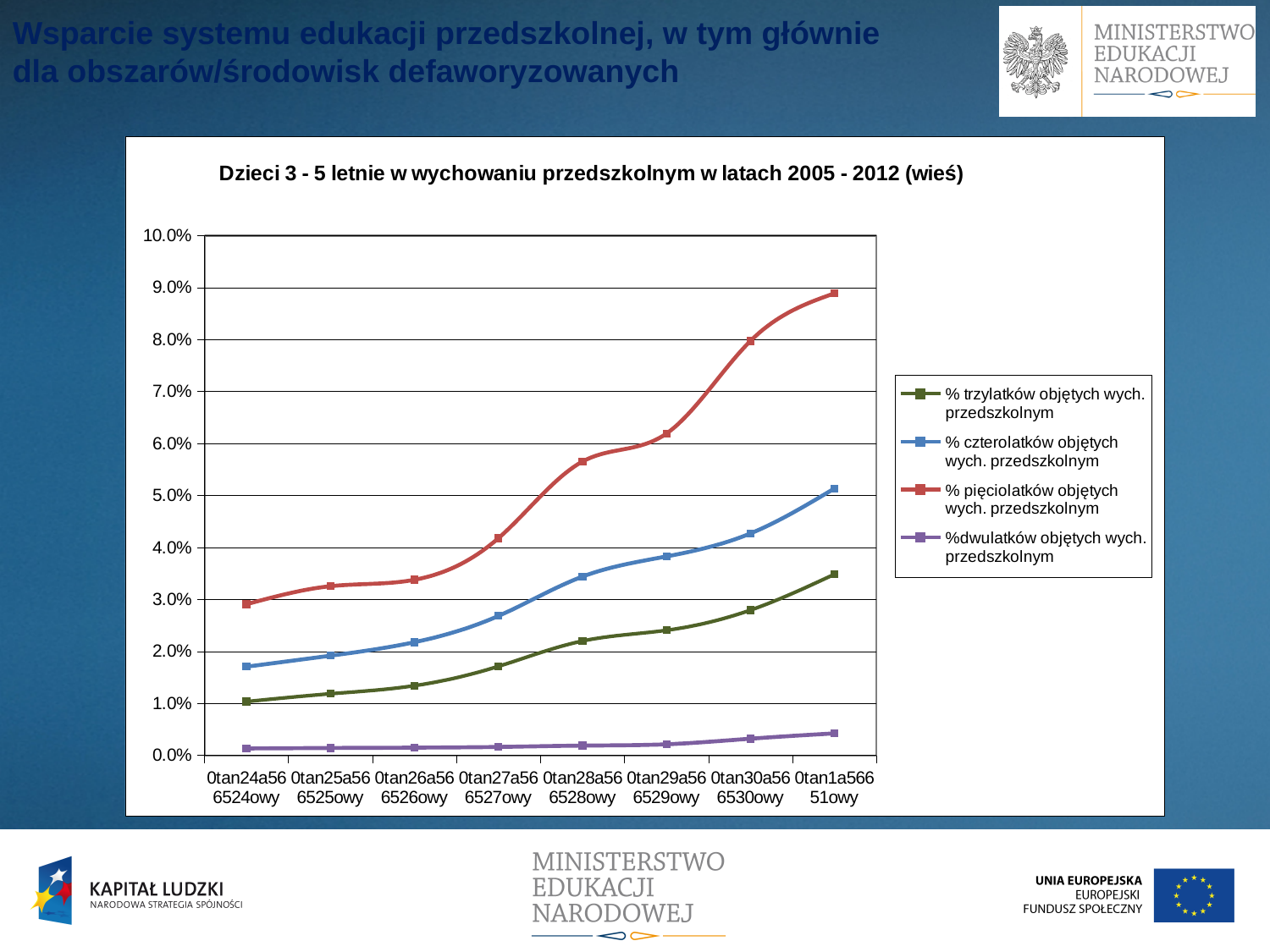
Which series has the highest values across the whole chart? % pięciolatków objętych wych. przedszkolnym How many data points does each line have? 8 Do the values of the % pięciolatków objętych wych. przedszkolnym series rise or fall from left to right? rise How many series does the legend list? 4 What kind of chart is shown on the slide? line chart Which series is drawn in red? % pięciolatków objętych wych. przedszkolnym Is the last value of the % pięciolatków objętych wych. przedszkolnym series greater or less than 8.0%? greater Is the last value of the % trzylatków objętych wych. przedszkolnym series greater or less than 3.0%? greater At the last point on the x axis, which is larger: the % pięciolatków series or the % czterolatków series? % pięciolatków objętych wych. przedszkolnym Is the first value of the % czterolatków objętych wych. przedszkolnym series greater or less than 2.0%? less What is the title of the chart? Dzieci 3 - 5 letnie w wychowaniu przedszkolnym w latach 2005 - 2012 (wieś) Which series has the lowest values across the whole chart? %dwulatków objętych wych. przedszkolnym